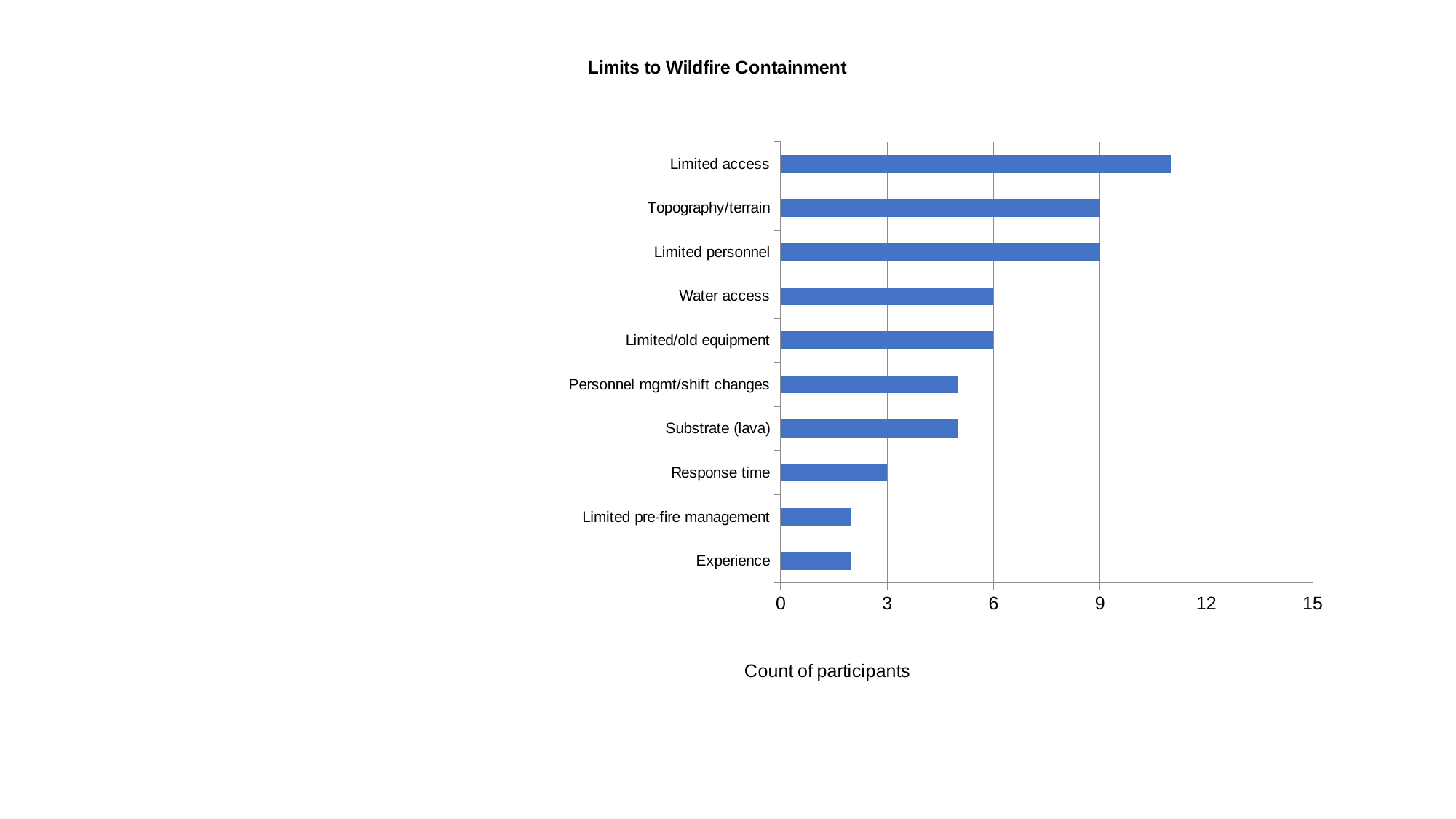
Is the value for Substrate (lava) greater or less than 6? less What is the label of the horizontal axis? Count of participants What is the count of participants for Response time? 3 What is the title of the chart? Limits to Wildfire Containment Is the value for Limited access greater or less than 9? greater Which category has the highest count of participants? Limited access What is the count of participants for Topography/terrain? 9 Which has a higher count of participants, Limited access or Water access? Limited access What type of chart is shown on the slide? bar chart What is the difference between the counts for Limited personnel and Limited/old equipment? 3 What is the count of participants for Water access? 6 How many categories are shown in the chart? 10